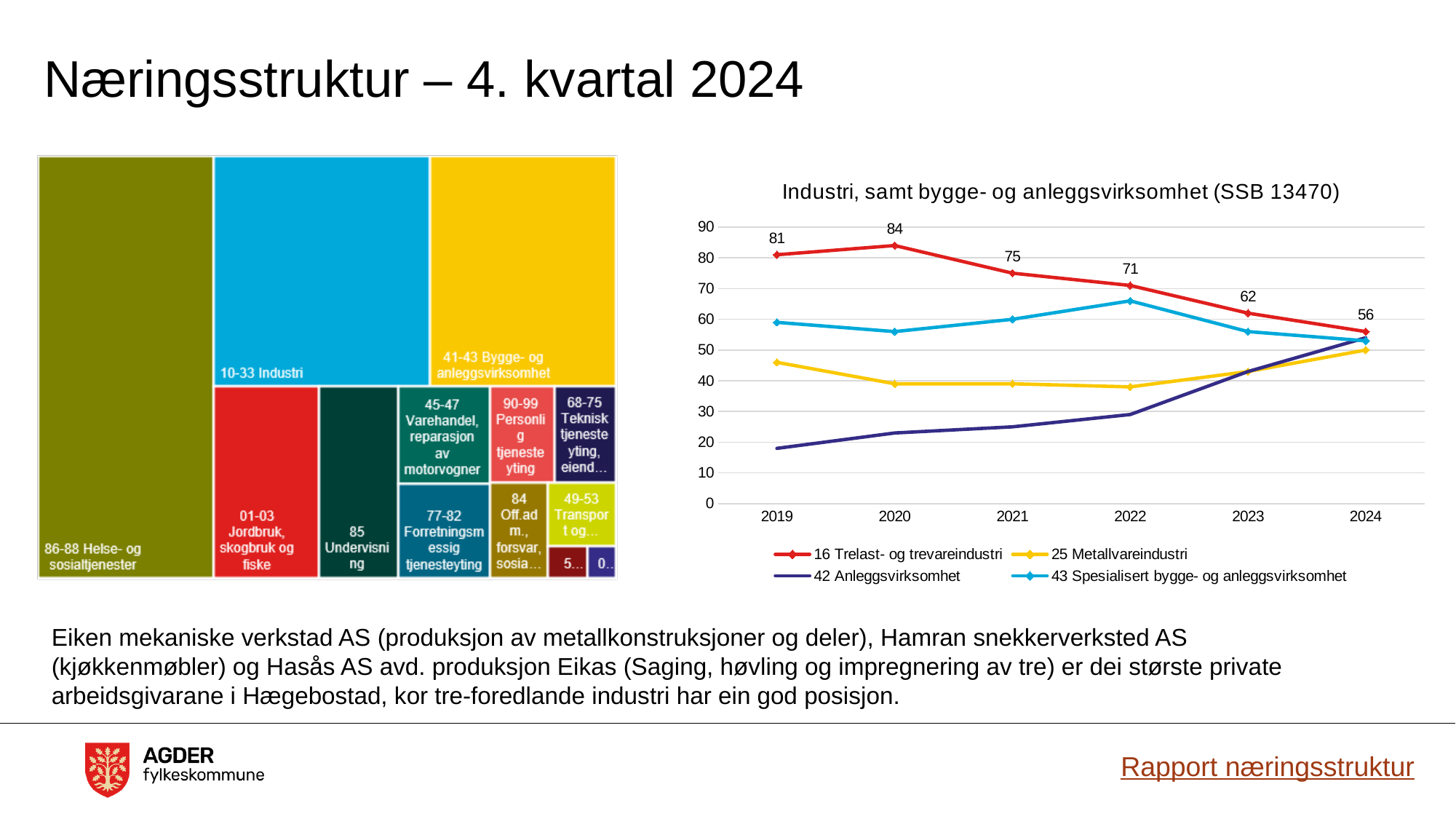
In the line chart 'Industri, samt bygge- og anleggsvirksomhet (SSB 13470)', in which year is 16 Trelast- og trevareindustri lowest? 2024 In the line chart 'Industri, samt bygge- og anleggsvirksomhet (SSB 13470)', which is larger in 2019: 16 Trelast- og trevareindustri or 25 Metallvareindustri? 16 Trelast- og trevareindustri In the line chart 'Industri, samt bygge- og anleggsvirksomhet (SSB 13470)', does 16 Trelast- og trevareindustri rise or fall from 2020 to 2024? fall In the line chart 'Industri, samt bygge- og anleggsvirksomhet (SSB 13470)', in which year is 16 Trelast- og trevareindustri highest? 2020 How many series does the legend of the line chart 'Industri, samt bygge- og anleggsvirksomhet (SSB 13470)' list? 4 In the line chart 'Industri, samt bygge- og anleggsvirksomhet (SSB 13470)', is the value for 43 Spesialisert bygge- og anleggsvirksomhet in 2022 greater or less than 60? greater In the line chart 'Industri, samt bygge- og anleggsvirksomhet (SSB 13470)', does 42 Anleggsvirksomhet rise or fall from 2019 to 2024? rise In the line chart 'Industri, samt bygge- og anleggsvirksomhet (SSB 13470)', what is the value for 16 Trelast- og trevareindustri in 2020? 84 In the line chart 'Industri, samt bygge- og anleggsvirksomhet (SSB 13470)', what is the value for 16 Trelast- og trevareindustri in 2024? 56 In the line chart 'Industri, samt bygge- og anleggsvirksomhet (SSB 13470)', is the value for 42 Anleggsvirksomhet in 2019 greater or less than 20? less In the line chart 'Industri, samt bygge- og anleggsvirksomhet (SSB 13470)', what is the difference between the 2019 and 2024 values for 16 Trelast- og trevareindustri? 25 In the treemap chart on the left of the slide, which category occupies the largest area? 86-88 Helse- og sosialtjenester